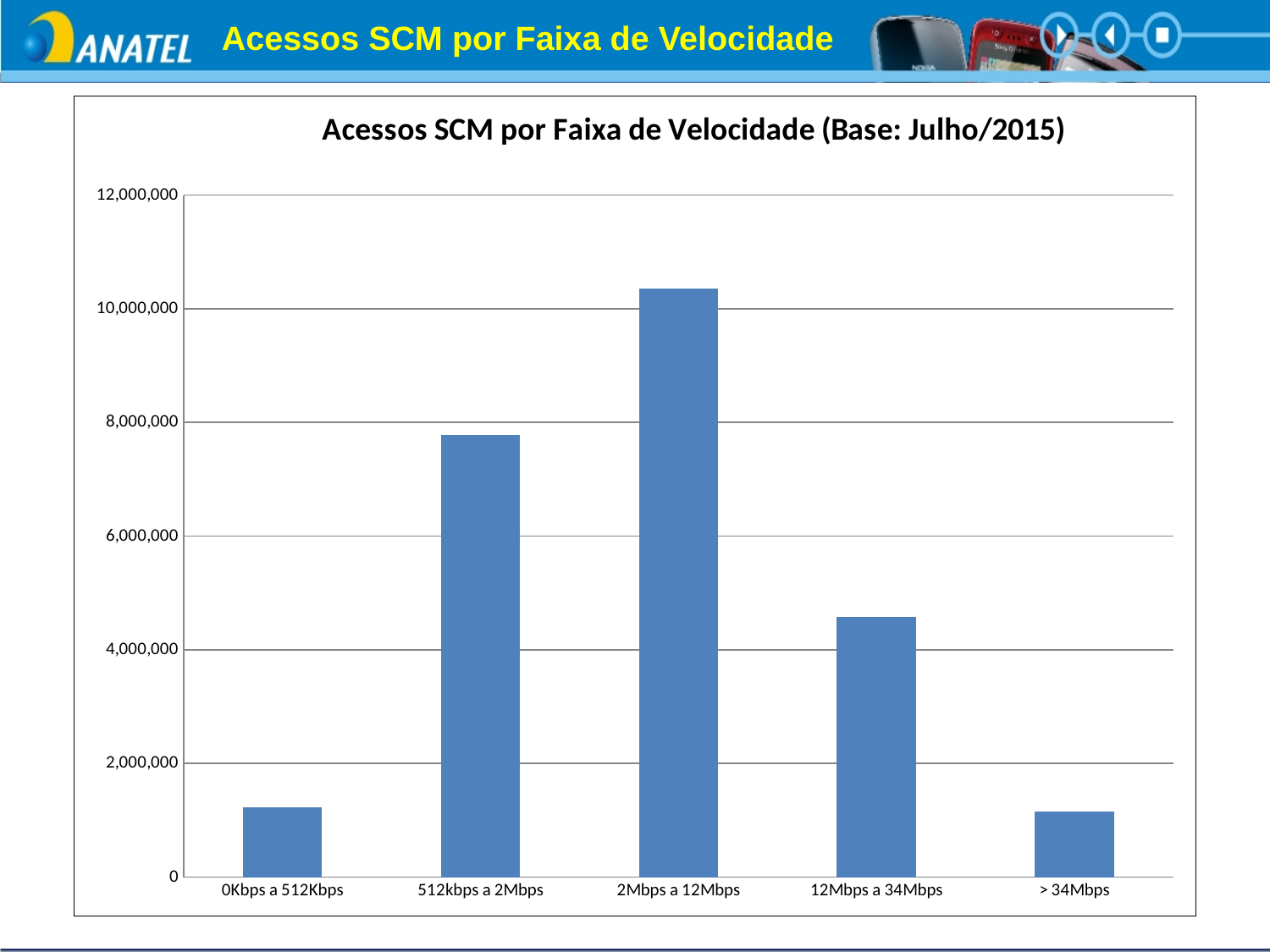
Is the value for 512kbps a 2Mbps greater or less than 8,000,000? less Is the value for > 34Mbps greater or less than 2,000,000? less Is the value for 12Mbps a 34Mbps greater or less than 4,000,000? greater What is the title of the chart? Acessos SCM por Faixa de Velocidade (Base: Julho/2015) Do the values rise or fall from 2Mbps a 12Mbps to > 34Mbps along the x axis? fall What is the highest value shown on the vertical axis? 12,000,000 What type of chart is shown on the slide? bar chart Which speed range has the highest number of accesses? 2Mbps a 12Mbps How many speed-range categories are plotted on the x axis? 5 Which is larger, the value for 512kbps a 2Mbps or the value for 12Mbps a 34Mbps? 512kbps a 2Mbps